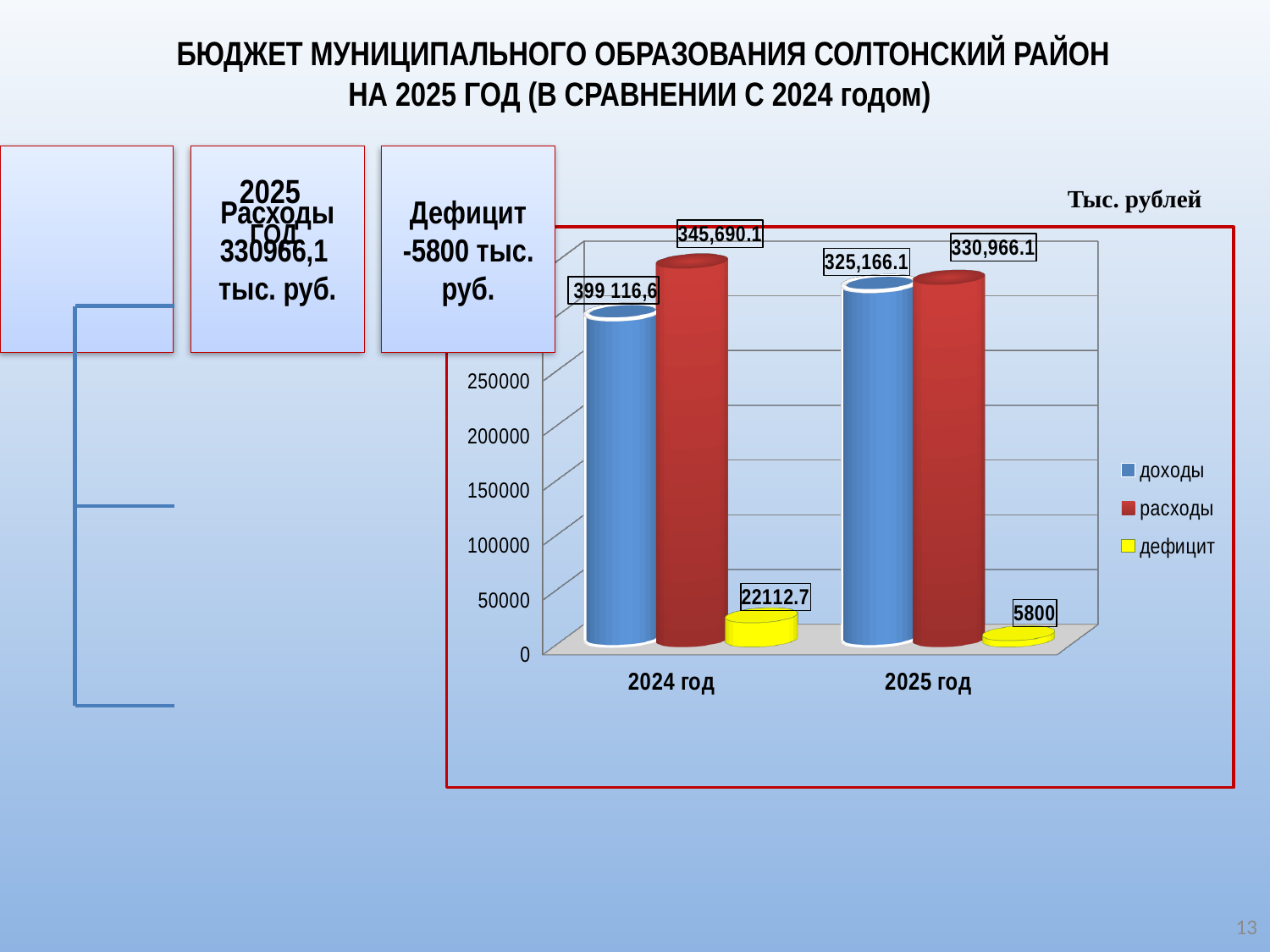
What is the difference between расходы and доходы for 2025 год? 5,800 How many series does the legend list? 3 By how much does дефицит for 2024 год exceed дефицит for 2025 год? 16312.7 Does the value of расходы rise or fall from 2024 год to 2025 год? fall What is the value of дефицит for 2024 год? 22112.7 Is the value of дефицит for 2024 год greater or less than 50000? less What is the value of доходы for 2025 год? 325,166.1 What is the value of расходы for 2024 год? 345,690.1 How many categories are shown on the x axis? 2 What is the value of дефицит for 2025 год? 5800 What is the value of расходы for 2025 год? 330,966.1 Which year has the larger дефицит, 2024 год or 2025 год? 2024 год